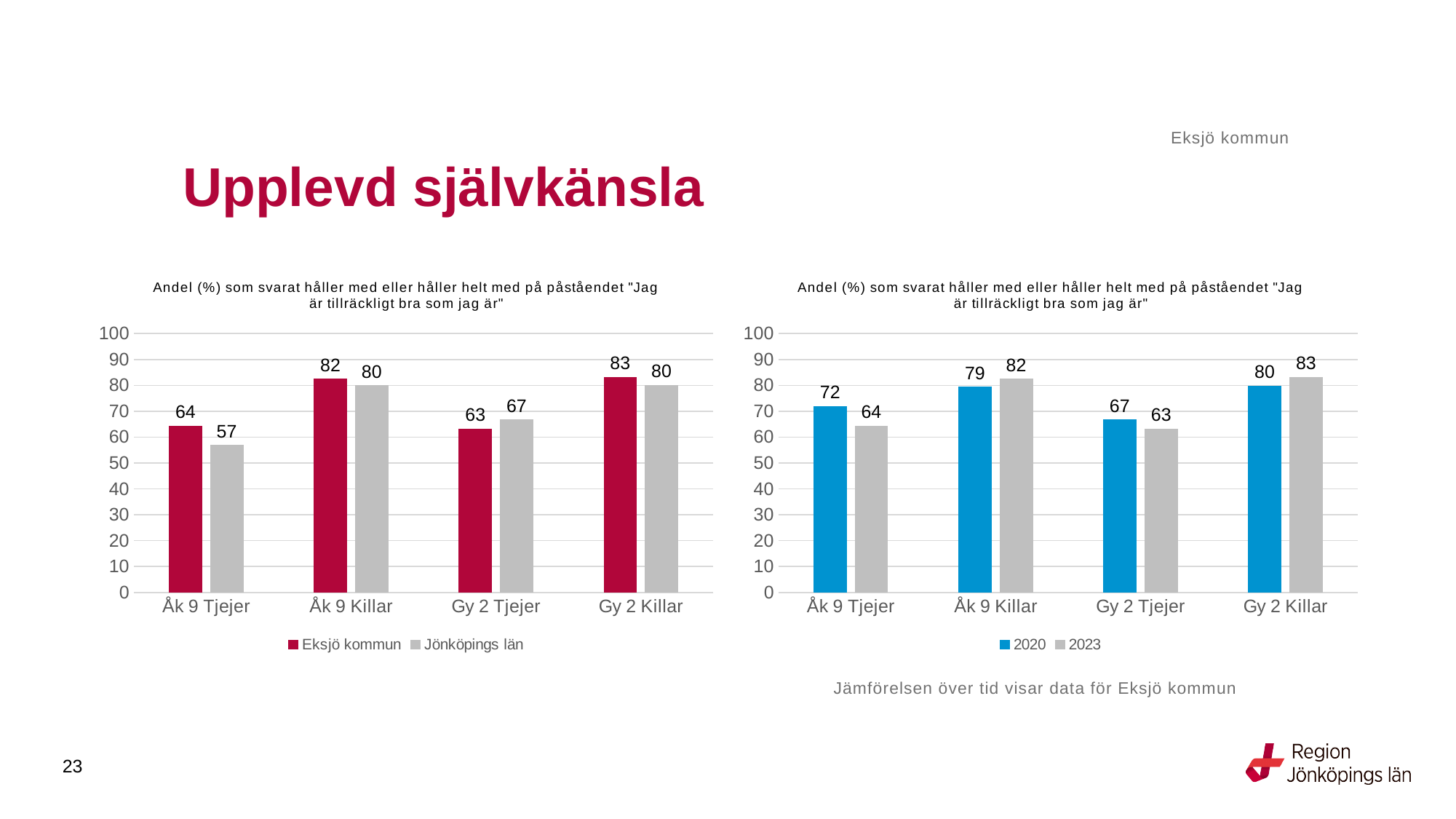
In the left chart, which category has the highest value for Eksjö kommun? Gy 2 Killar In the right chart, what is the value for 2020 for Åk 9 Killar? 79 In the left chart, which is larger for Gy 2 Tjejer: Eksjö kommun or Jönköpings län? Jönköpings län In the left chart, what is the difference between Eksjö kommun and Jönköpings län for Åk 9 Tjejer? 7 How many series does the legend of the right chart list? 2 In the right chart, what is the value for 2023 for Gy 2 Killar? 83 In the right chart, which category has the lowest value for 2023? Gy 2 Tjejer What kind of chart is the left chart? Bar chart In the left chart, what is the value for Jönköpings län for Gy 2 Tjejer? 67 In the left chart, which category has the lowest value for Jönköpings län? Åk 9 Tjejer In the left chart, what is the value for Eksjö kommun for Åk 9 Tjejer? 64 In the right chart, what is the difference between 2020 and 2023 for Åk 9 Tjejer? 8